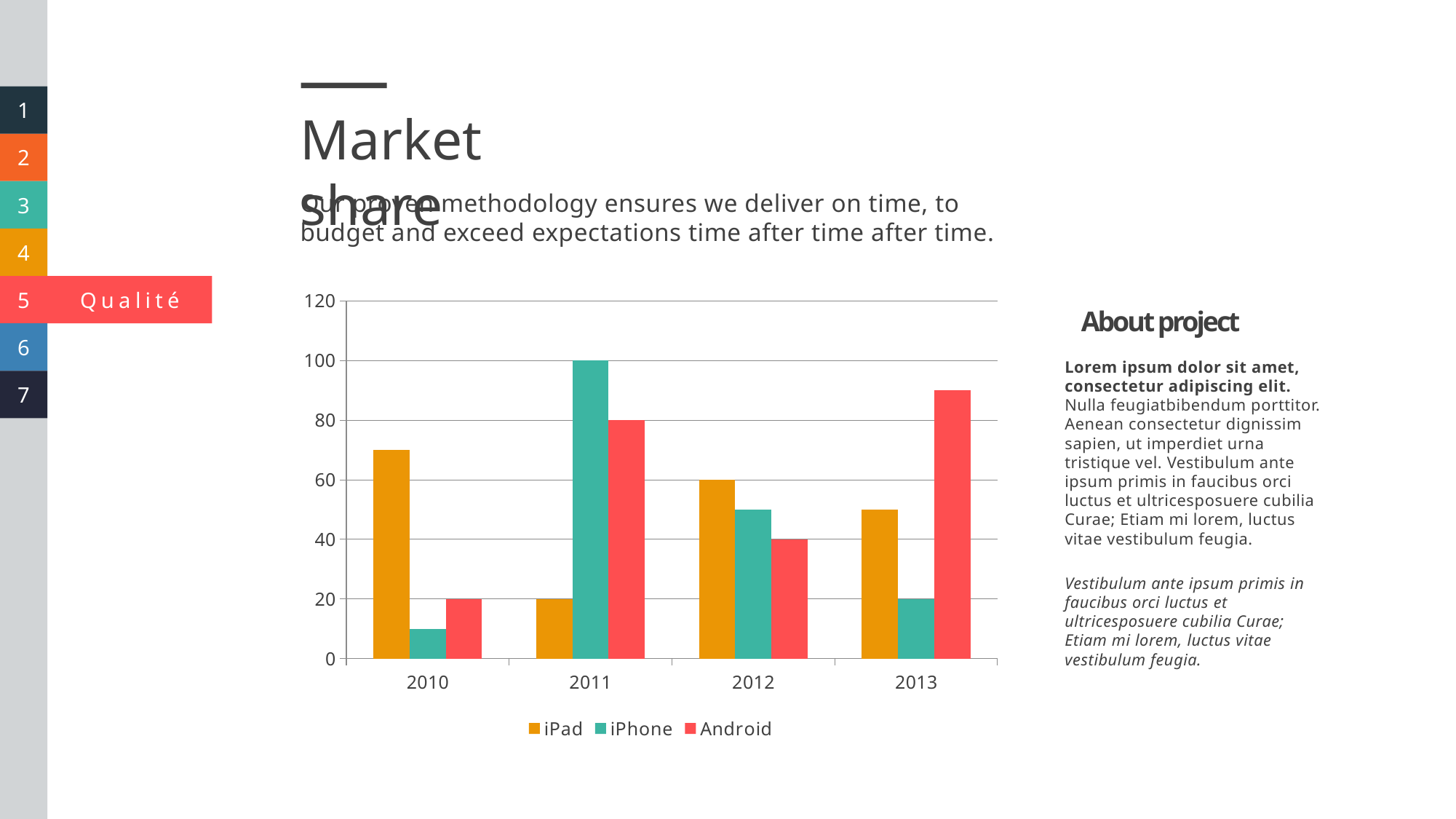
What is the value for Android in 2010? 20 Which series has the lowest bar in 2010? iPhone Is the value for Android in 2013 greater or less than 80? greater How many years are shown on the x axis of the chart? 4 Which is larger: Android in 2011 or iPad in 2012? Android in 2011 How many series does the chart legend list? 3 What is the value for iPad in 2012? 60 Which series has the highest bar in 2011? iPhone What is the difference between the iPhone and Android values in 2011? 20 What is the value for iPhone in 2011? 100 What is the value for Android in 2011? 80 What type of chart is shown on the slide? bar chart